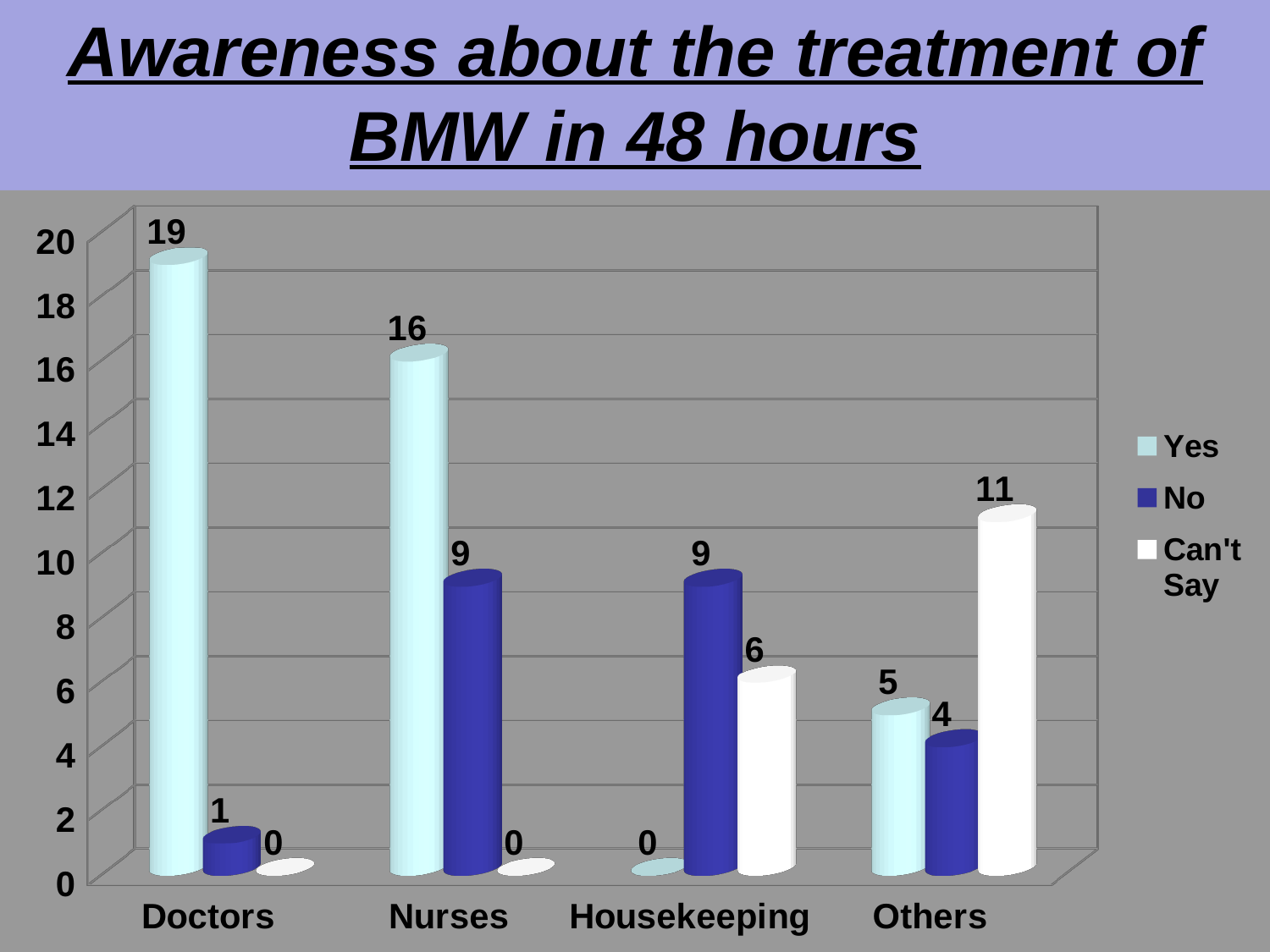
What is the value for No for Nurses? 9 What is the value for Can't Say for Others? 11 What is the value for Yes for Housekeeping? 0 How many categories are shown on the x axis? 4 Which is larger for Others: the Yes value or the Can't Say value? Can't Say What is the value for Yes for Doctors? 19 What kind of chart is shown on the slide? Bar chart How many series does the legend list? 3 What is the difference between the Yes values for Doctors and Nurses? 3 Which category has the lowest Can't Say value? Doctors and Nurses (both 0) What is the title of the chart? Awareness about the treatment of BMW in 48 hours Which category has the highest Yes value? Doctors